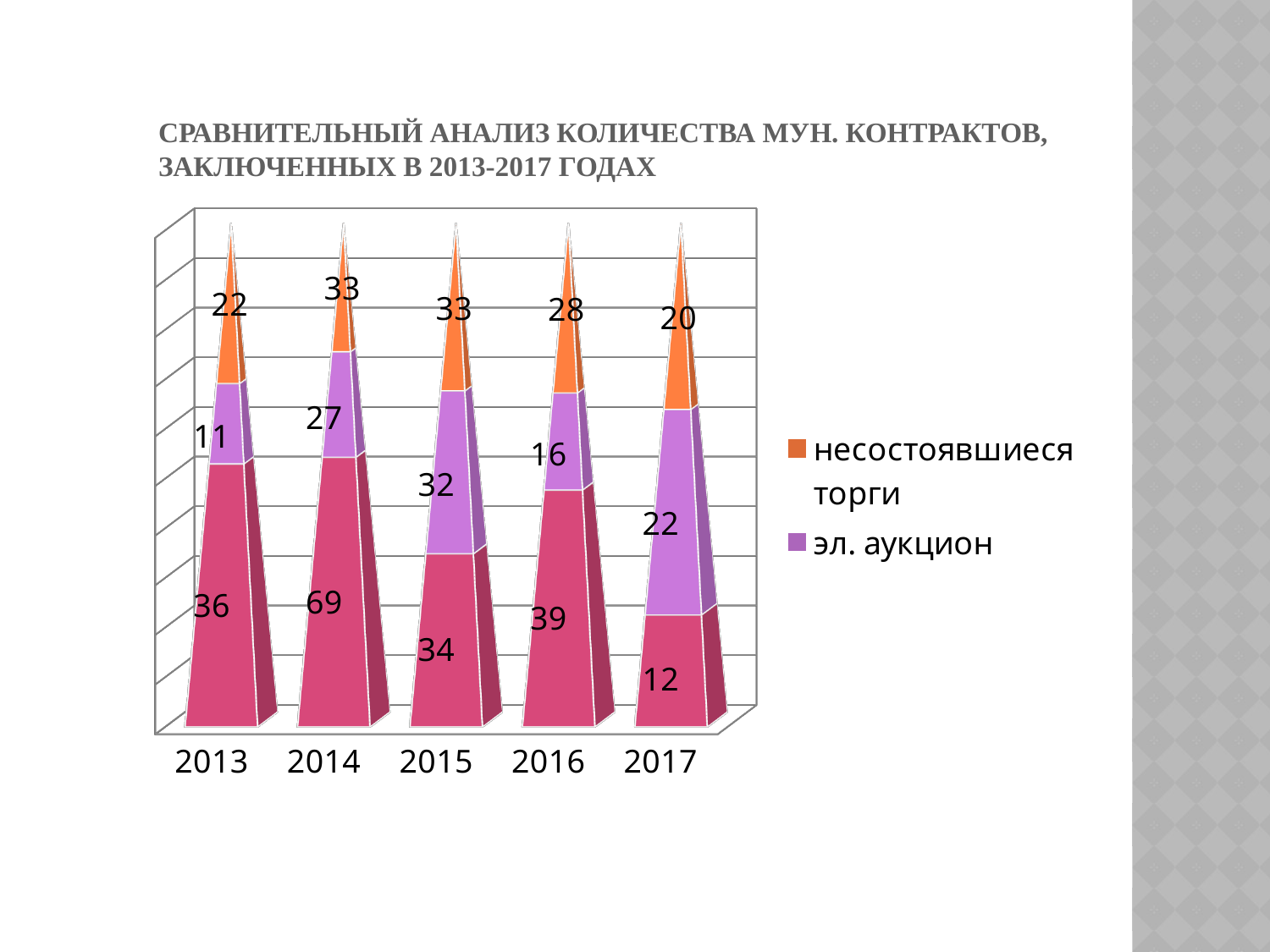
How many series does the legend list? 2 Does the value for эл. аукцион rise or fall from 2013 to 2015? Rise What is the value of the bottom (pink) segment of the 2016 bar? 39 What is the value for несостоявшиеся торги in 2017? 20 What is the total of the stacked bar for 2014? 129 In which year is the value for эл. аукцион the highest? 2015 In which year is the value for эл. аукцион the lowest? 2013 Which year has the larger value for эл. аукцион, 2014 or 2017? 2014 How many years are shown on the x axis? 5 What is the value for эл. аукцион in 2015? 32 What kind of chart is shown on the slide? Stacked bar chart What is the difference between the несостоявшиеся торги values for 2016 and 2017? 8